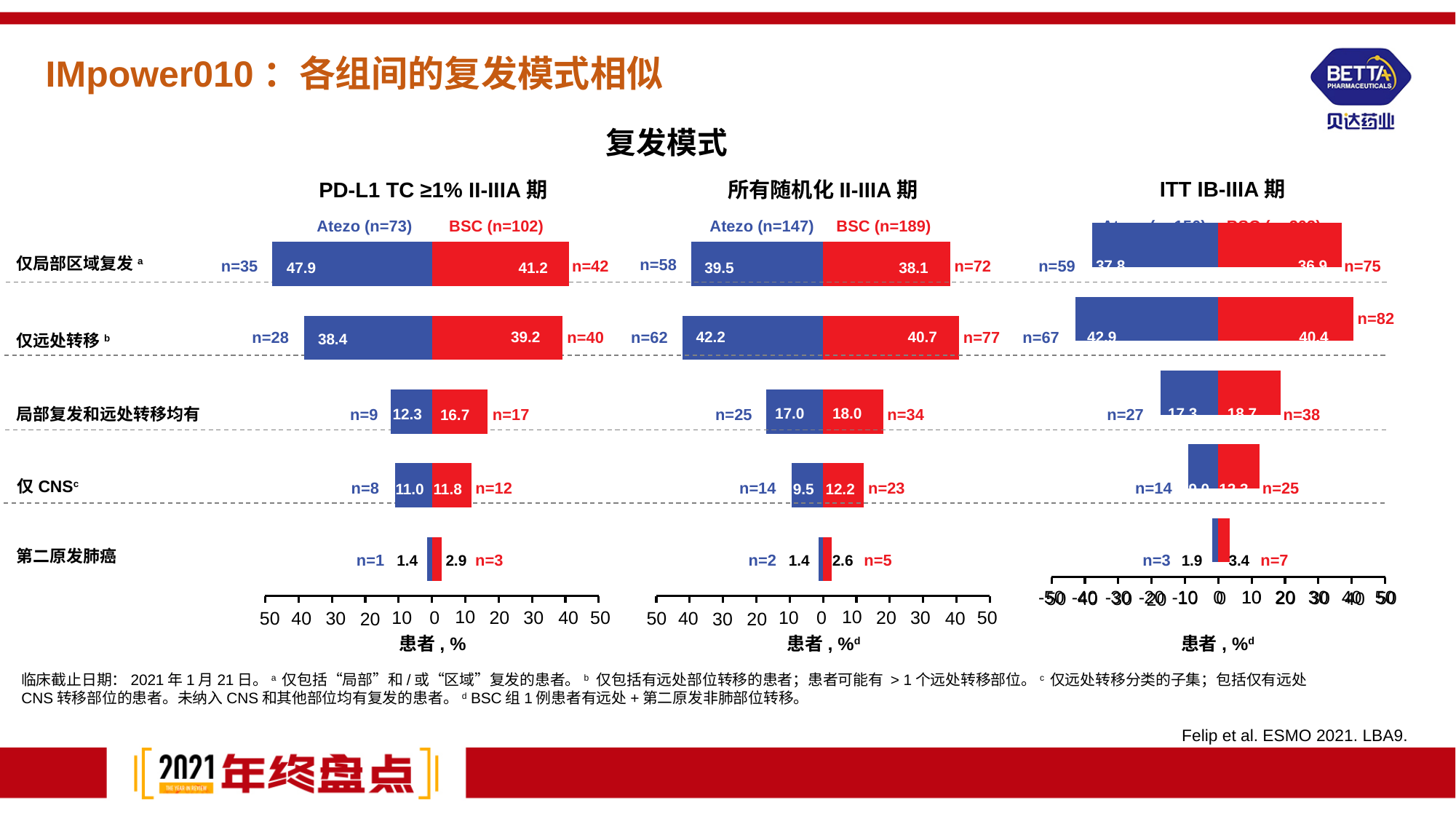
In the 所有随机化 II-IIIA 期 chart, what is the Atezo value for 仅远处转移? 42.2 In the 所有随机化 II-IIIA 期 chart, which category has the lowest BSC value? 第二原发肺癌 In the PD-L1 TC ≥1% II-IIIA 期 chart, what is the Atezo value for 仅局部区域复发? 47.9 What type of chart is used for the PD-L1 TC ≥1% II-IIIA 期 panel? Bar chart In the 所有随机化 II-IIIA 期 chart, what is the BSC value for 仅 CNS? 12.2 How many recurrence categories are shown in the 所有随机化 II-IIIA 期 chart? 5 In the ITT IB-IIIA 期 chart, what is the BSC value for 第二原发肺癌? 3.4 In the 所有随机化 II-IIIA 期 chart, what is the sample size (n) of the BSC group shown in the header? n=189 In the PD-L1 TC ≥1% II-IIIA 期 chart, which category has the highest Atezo value? 仅局部区域复发 In the PD-L1 TC ≥1% II-IIIA 期 chart, what is the difference between the Atezo and BSC values for 仅局部区域复发? 6.7 In the PD-L1 TC ≥1% II-IIIA 期 chart, what is the BSC value for 仅远处转移? 39.2 In the 所有随机化 II-IIIA 期 chart, which is larger for 局部复发和远处转移均有, the Atezo value or the BSC value? BSC